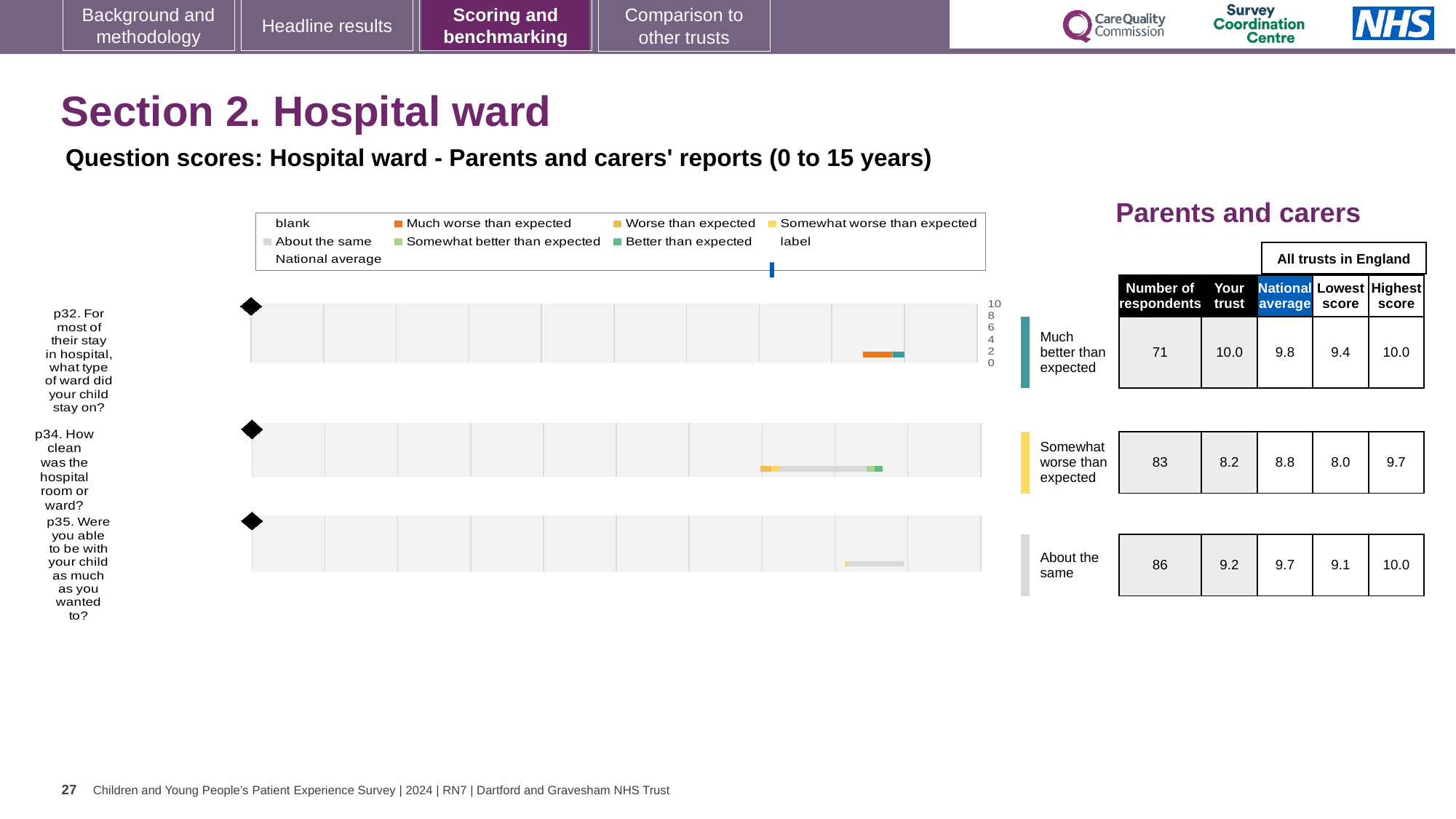
What kind of chart is used to show the question scores for the Hospital ward section? Bar chart Which question has the highest 'Your trust' score? p32 What is the national average score for p35 (were you able to be with your child as much as you wanted to)? 9.7 For p32, which is larger: the 'Your trust' score or the national average? Your trust What is the 'Your trust' score for p34 (how clean was the hospital room or ward)? 8.2 What is the 'Your trust' score for p32 (what type of ward did your child stay on)? 10.0 What benchmark category is shown for p34 (how clean was the hospital room or ward)? Somewhat worse than expected Which question has the lowest 'Your trust' score? p34 What is the lowest score among all trusts in England for p35? 9.1 How many respondents answered p34 (how clean was the hospital room or ward)? 83 What is the difference between the national average and the 'Your trust' score for p34? 0.6 How many questions (categories) are plotted in the Hospital ward question scores chart? 3